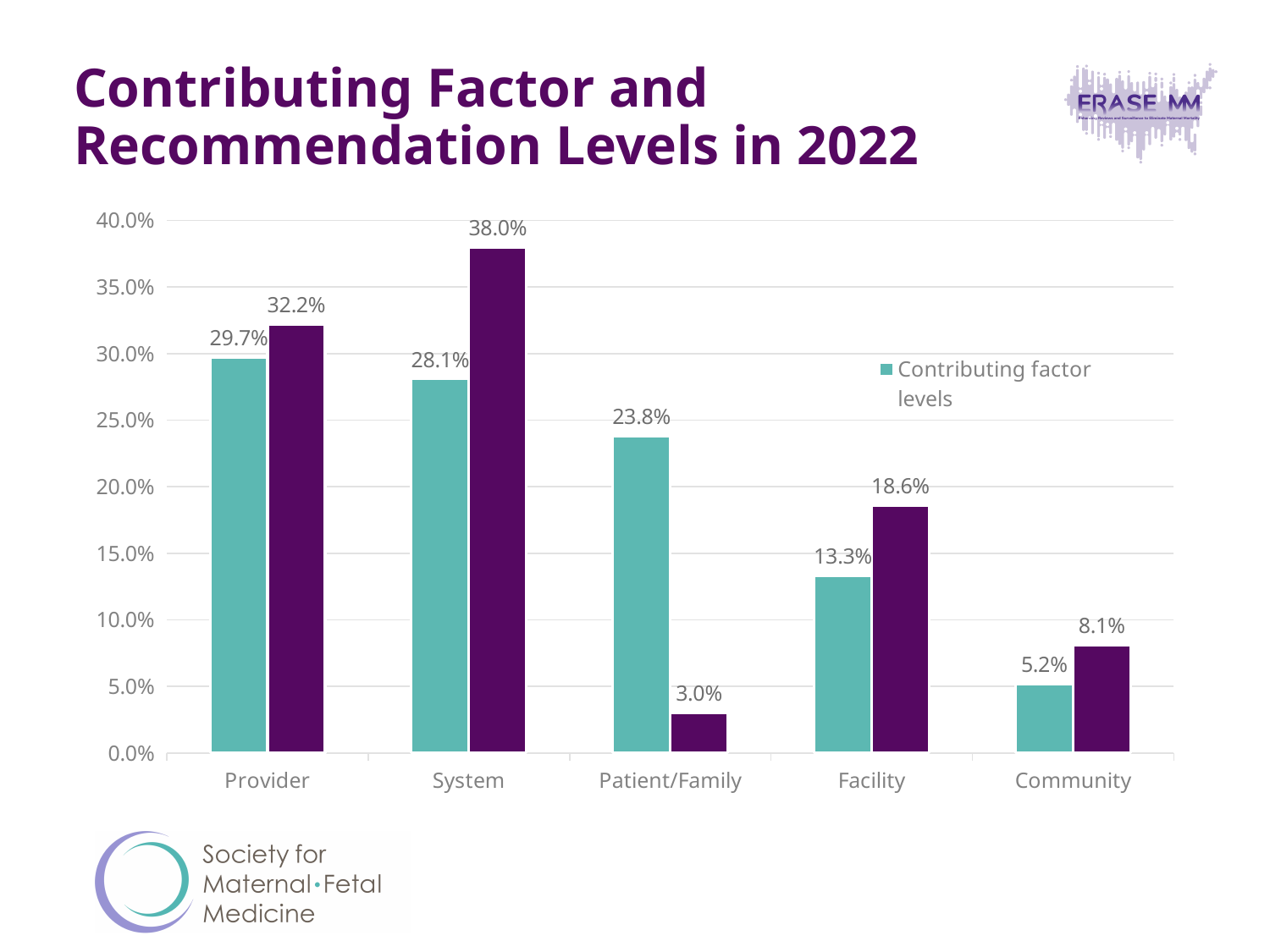
What is the value of the purple bar for Community? 8.1% What kind of chart is shown on the slide? Bar chart Which category has the highest Contributing factor levels value? Provider How many categories are shown on the x axis? 5 What is the value of the purple bar for System? 38.0% How many series does the legend list? 1 Which is larger for Patient/Family: the Contributing factor levels bar or the purple bar? Contributing factor levels What is the difference between the purple bar and the Contributing factor levels bar for Facility? 5.3% What is the Contributing factor levels value for Patient/Family? 23.8% What is the Contributing factor levels value for Provider? 29.7% What is the title of the slide? Contributing Factor and Recommendation Levels in 2022 Which category has the lowest value for the purple bars? Patient/Family